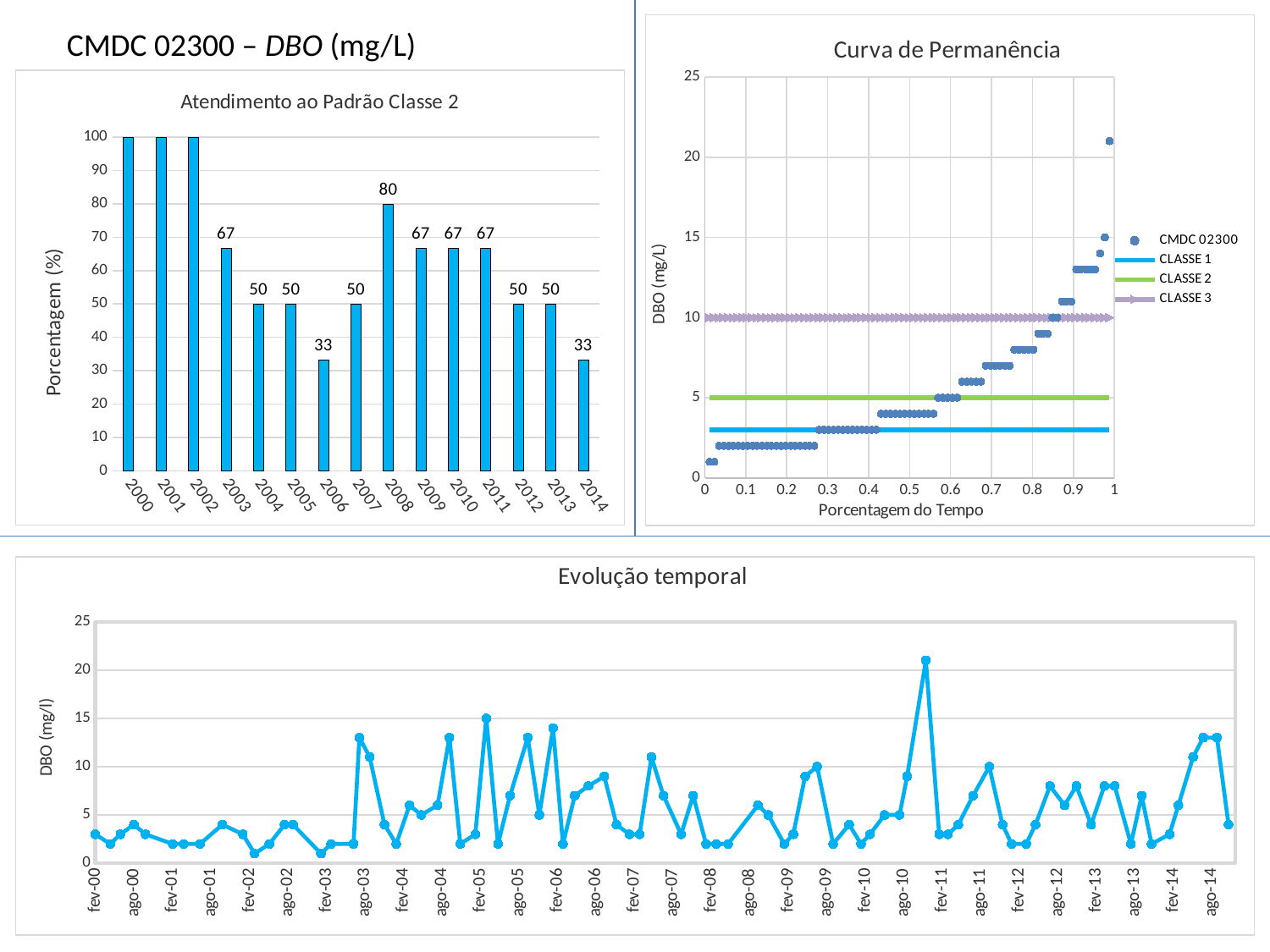
In the 'Atendimento ao Padrão Classe 2' chart, which year from 2003 to 2014 has the highest value? 2008 In the 'Evolução temporal' chart, is the highest value greater or less than 20? greater What is the x-axis title of the 'Curva de Permanência' chart? Porcentagem do Tempo In the 'Atendimento ao Padrão Classe 2' chart, what is the value for 2008? 80 In the 'Atendimento ao Padrão Classe 2' chart, what is the value for 2003? 67 What kind of chart is 'Atendimento ao Padrão Classe 2'? bar chart How many years (bars) are shown in the 'Atendimento ao Padrão Classe 2' chart? 15 In the 'Atendimento ao Padrão Classe 2' chart, do the values rise or fall from 2000 to 2006? fall In the 'Atendimento ao Padrão Classe 2' chart, what is the difference between the values for 2008 and 2003? 13 In the 'Atendimento ao Padrão Classe 2' chart, what is the value for 2006? 33 How many series does the legend of the 'Curva de Permanência' chart list? 4 In the 'Atendimento ao Padrão Classe 2' chart, which is larger, the value for 2008 or the value for 2012? 2008